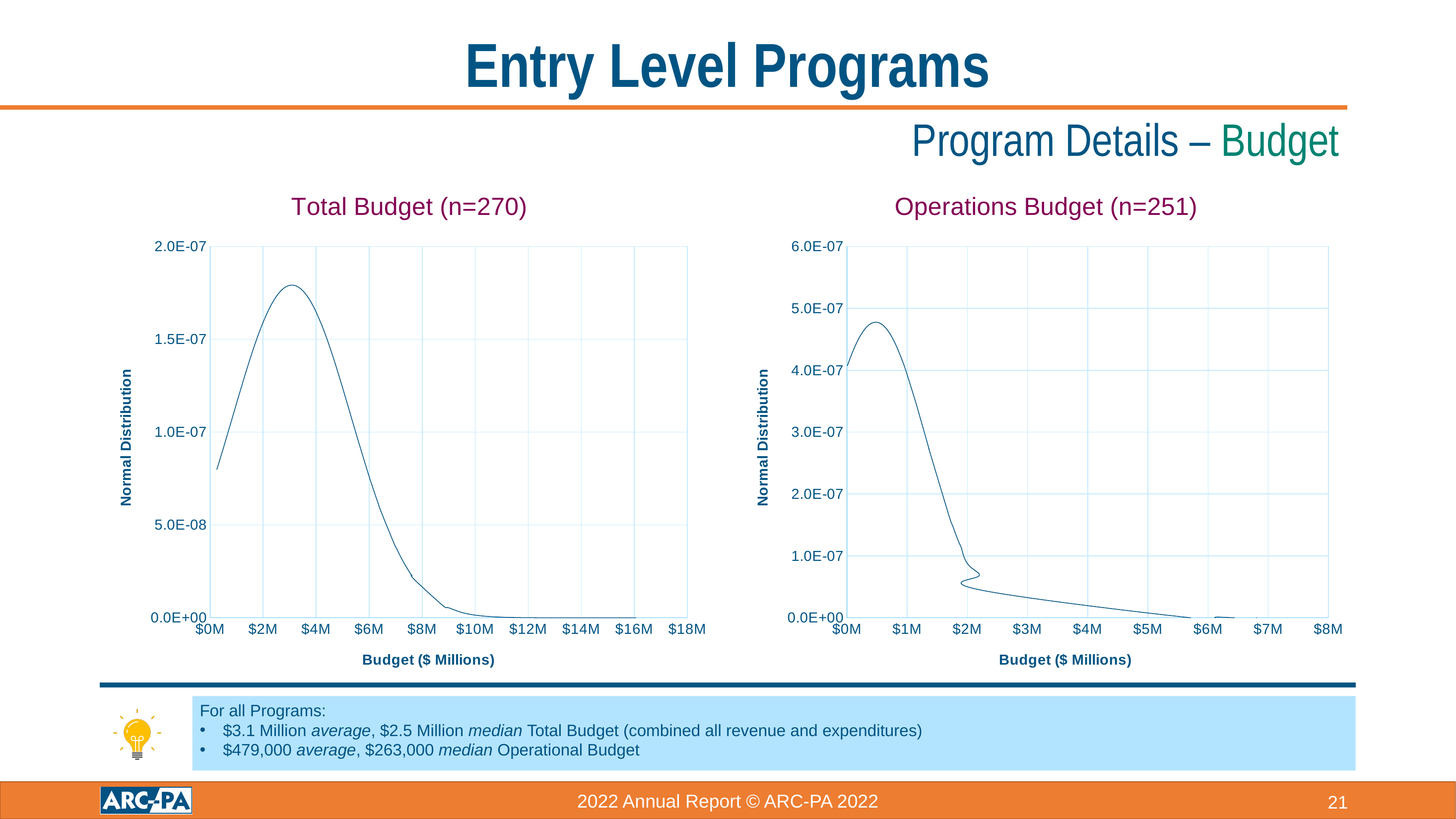
In the Total Budget (n=270) chart, is the value at $2M larger or smaller than the value at $8M? larger What kind of chart is the Operations Budget (n=251) chart? line chart In the Total Budget (n=270) chart, is the value at $3M greater or less than 1.5E-07? greater What is the x-axis title of the Operations Budget (n=251) chart? Budget ($ Millions) What is the y-axis title of the Total Budget (n=270) chart? Normal Distribution In the Operations Budget (n=251) chart, is the value at $1M greater or less than 5.0E-07? less In the Operations Budget (n=251) chart, does the curve rise or fall between $1M and $2M? fall In the Operations Budget (n=251) chart, is the value at $3M greater or less than 1.0E-07? less What kind of chart is the Total Budget (n=270) chart? line chart In the Total Budget (n=270) chart, does the curve rise or fall between $4M and $10M? fall